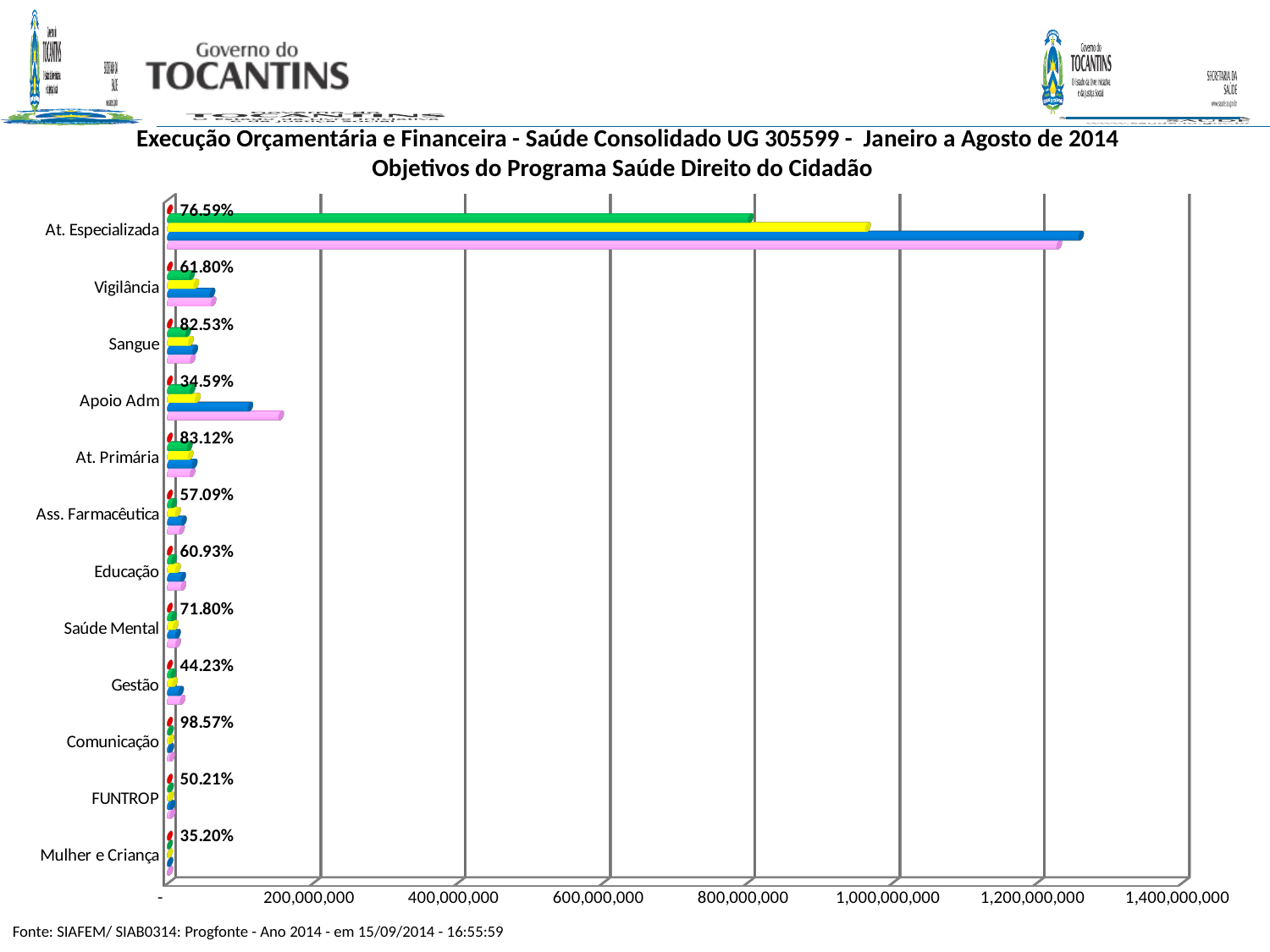
What is the difference between the percentage labels for Sangue and Vigilância? 20.73% Which category has the lowest percentage label? Apoio Adm What percentage is shown for Saúde Mental? 71.80% How many categories are listed on the vertical axis? 12 What percentage is shown for Comunicação? 98.57% Which category has the highest percentage label? Comunicação Is the value of the longest blue bar for At. Especializada greater or less than 1,200,000,000? greater What percentage is shown for Apoio Adm? 34.59% What percentage is shown for At. Especializada? 76.59% What is the subtitle of the chart, shown on the second line of the title? Objetivos do Programa Saúde Direito do Cidadão What kind of chart is shown on the slide? Bar chart Which has a higher percentage label, At. Primária or Educação? At. Primária